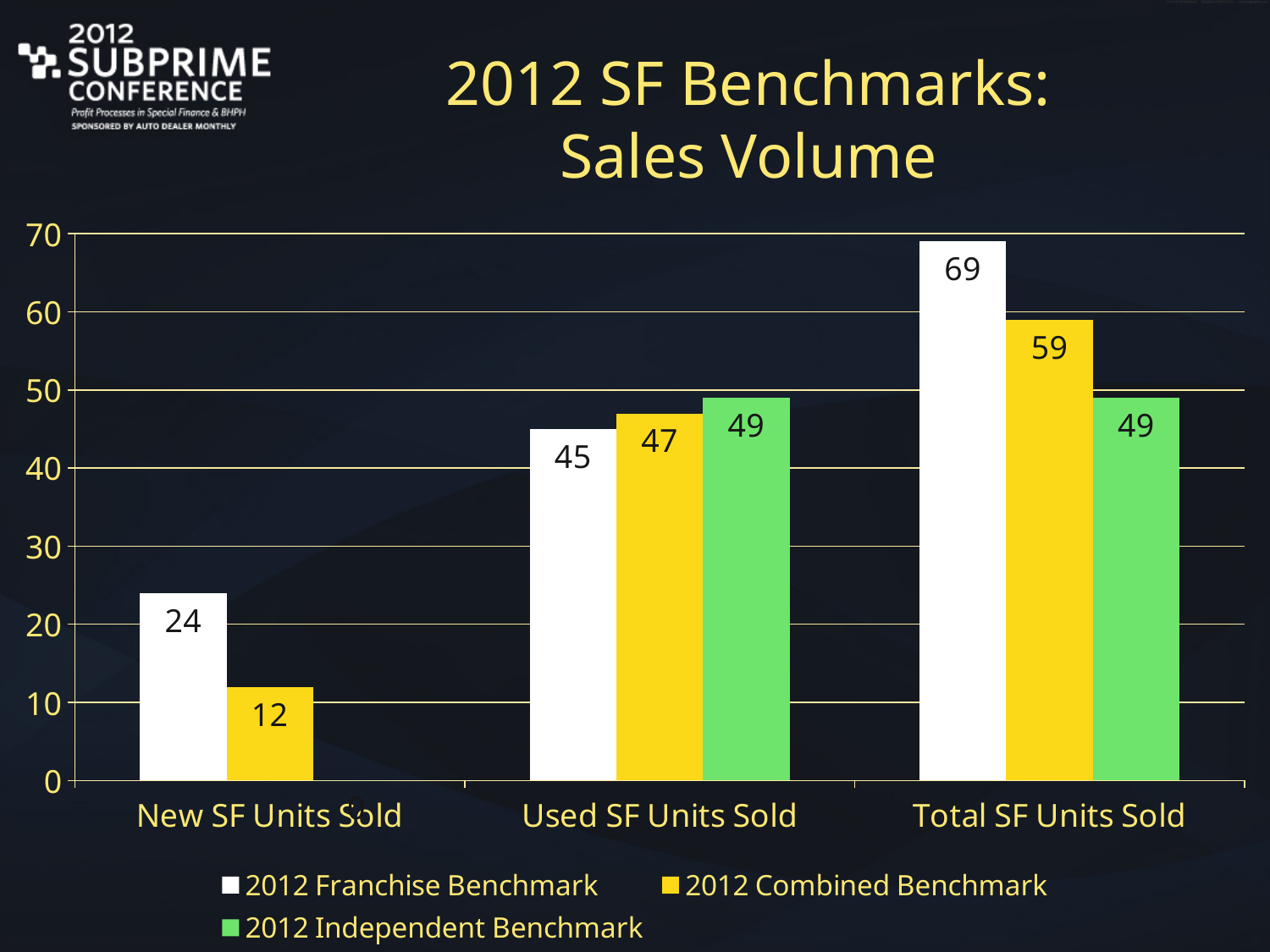
What kind of chart is shown on the slide? Bar chart What is the 2012 Independent Benchmark value for Used SF Units Sold? 49 How many series does the legend list? 3 Which category has the lowest 2012 Combined Benchmark value? New SF Units Sold How many categories are shown on the x axis? 3 What is the 2012 Franchise Benchmark value for New SF Units Sold? 24 What is the difference between the 2012 Franchise Benchmark and the 2012 Combined Benchmark for New SF Units Sold? 12 What is the title of the chart on the slide? 2012 SF Benchmarks: Sales Volume For Used SF Units Sold, which is larger: the 2012 Franchise Benchmark or the 2012 Independent Benchmark? 2012 Independent Benchmark What is the 2012 Combined Benchmark value for Total SF Units Sold? 59 What is the difference between the 2012 Franchise Benchmark and the 2012 Independent Benchmark for Total SF Units Sold? 20 Which category has the highest 2012 Franchise Benchmark value? Total SF Units Sold